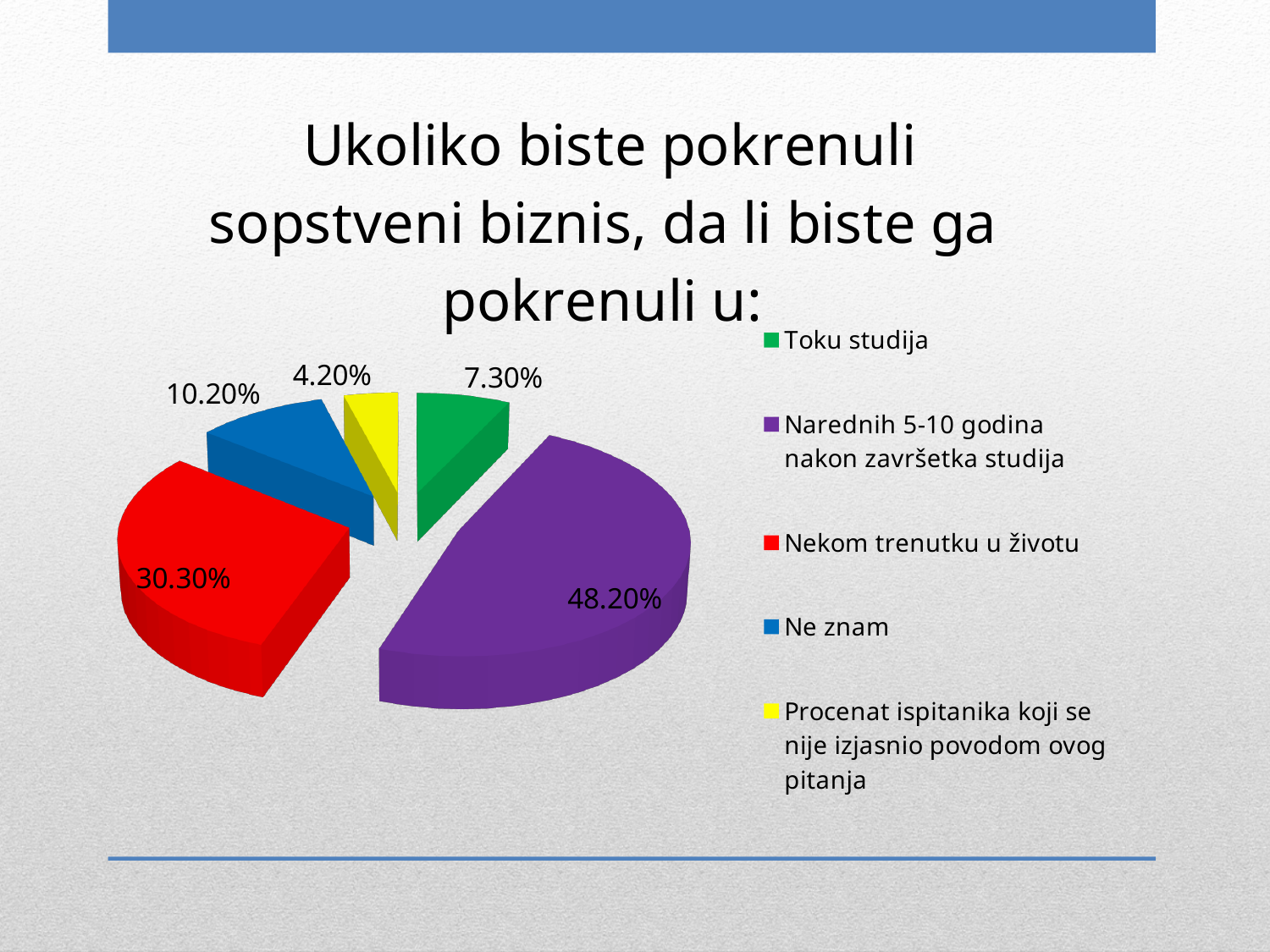
Which category has the smallest share of the pie? Procenat ispitanika koji se nije izjasnio povodom ovog pitanja Which category has the largest share of the pie? Narednih 5-10 godina nakon završetka studija How many slices does the pie chart have? 5 What is the difference in percentage points between "Narednih 5-10 godina nakon završetka studija" and "Nekom trenutku u životu"? 17.90% What percentage of respondents answered "Narednih 5-10 godina nakon završetka studija"? 48.20% What percentage of respondents answered "Ne znam"? 10.20% What percentage of respondents answered "Toku studija"? 7.30% What kind of chart is shown on the slide? pie chart What percentage of respondents answered "Nekom trenutku u životu"? 30.30% Which is larger, the share for "Ne znam" or the share for "Toku studija"? Ne znam What percentage is shown for respondents who did not answer this question ("Procenat ispitanika koji se nije izjasnio povodom ovog pitanja")? 4.20% What colour is the slice for "Nekom trenutku u životu"? red